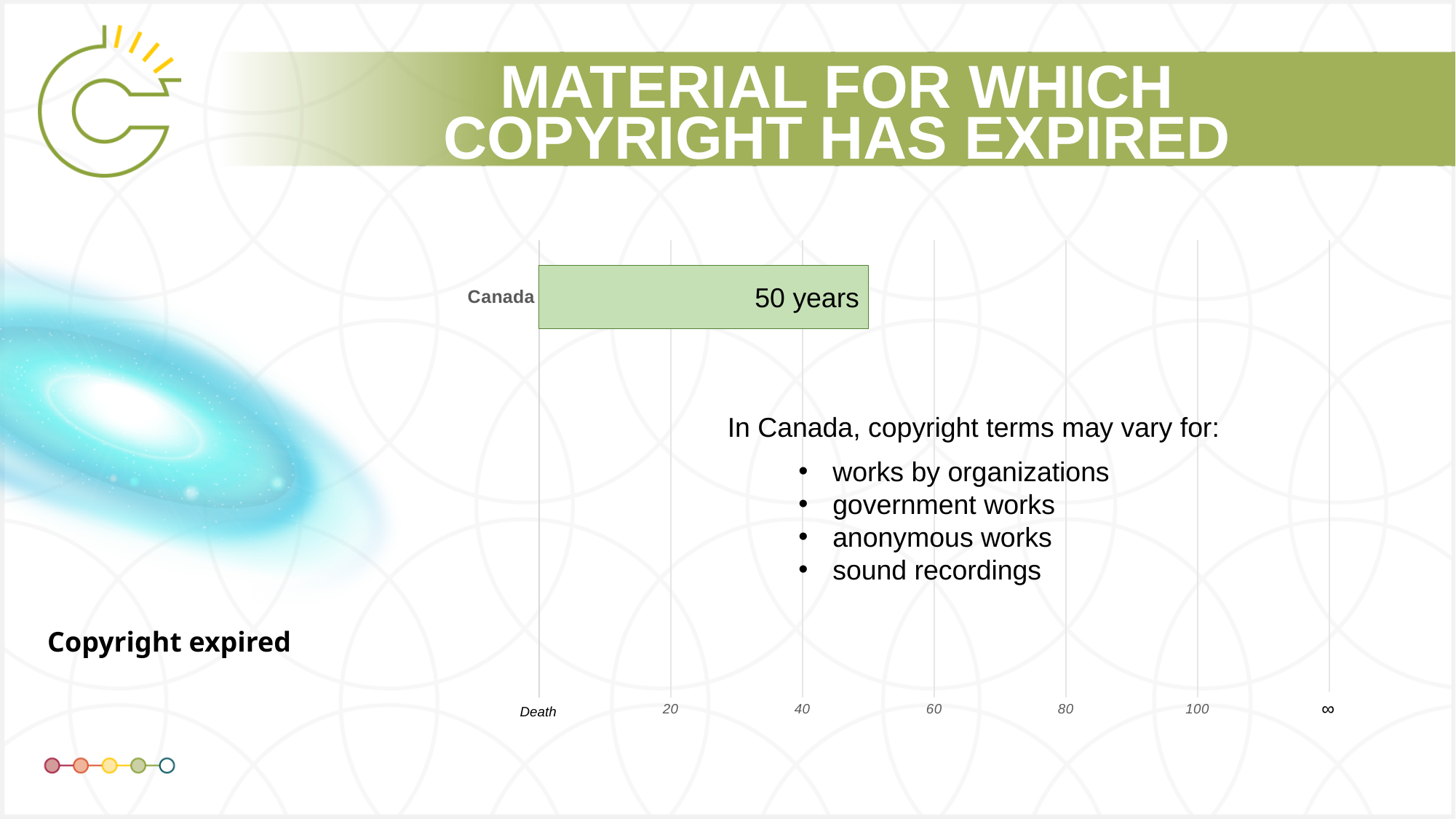
Is the value for Canada greater or less than 60? less Which category is plotted in the chart? Canada What is the label at the right end of the x axis? ∞ What is the label at the left end of the x axis? Death Is the value for Canada greater or less than 100? less What kind of chart is shown on the slide? bar chart Is the value for Canada greater or less than 40? greater How many categories are plotted in the chart? 1 What is the value shown for Canada? 50 years